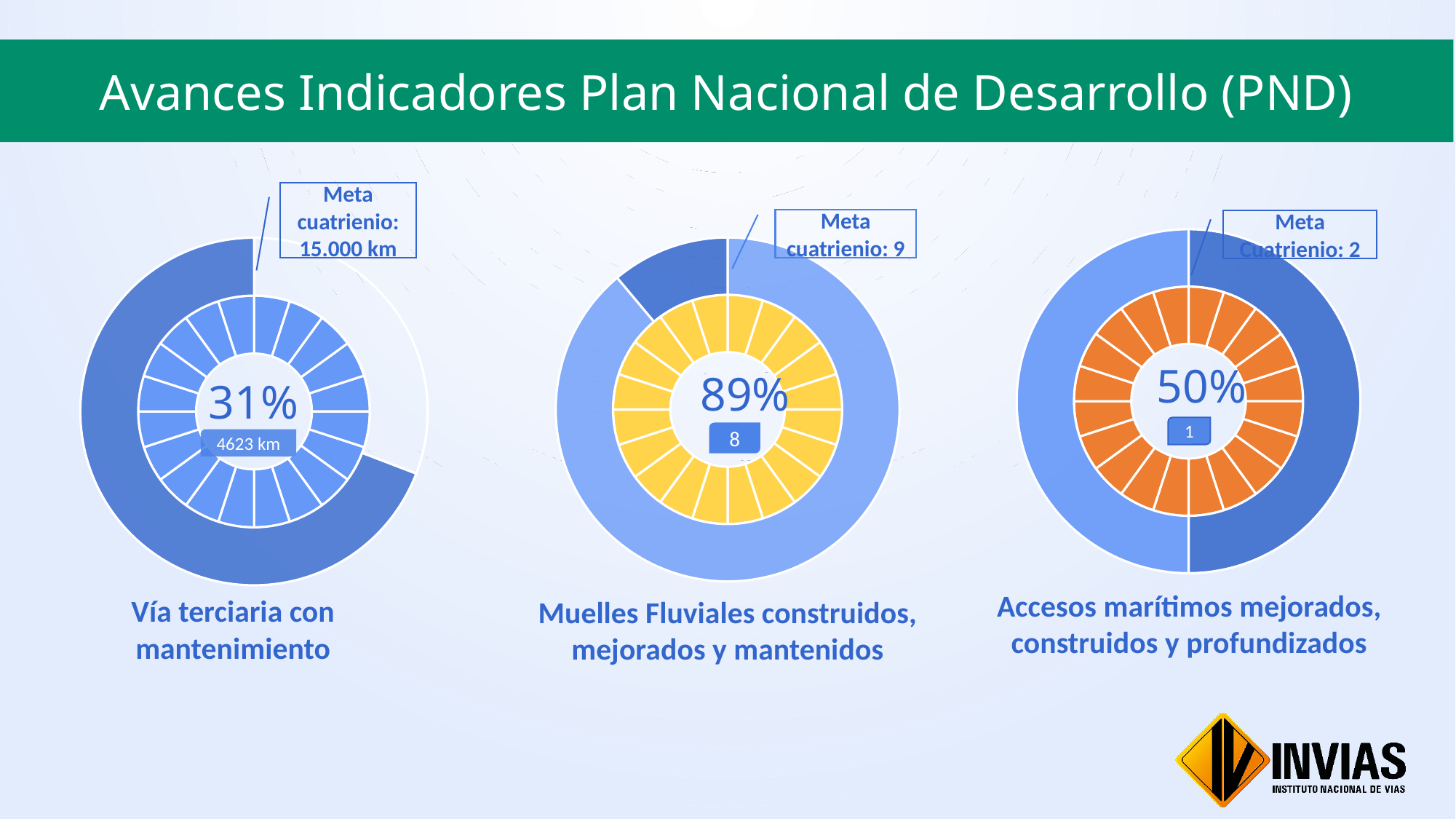
Which of the three indicators on the slide shows the lowest percentage of progress? Vía terciaria con mantenimiento On the 'Muelles Fluviales' chart, what is the 'Meta cuatrienio' target? 9 How many charts are shown on the slide? 3 What percentage of progress is shown on the 'Muelles Fluviales construidos, mejorados y mantenidos' chart? 89% On the 'Vía terciaria con mantenimiento' chart, how many kilometres have been achieved so far? 4623 km What percentage of progress is shown on the 'Accesos marítimos mejorados, construidos y profundizados' chart? 50% On the 'Accesos marítimos' chart, what is the 'Meta Cuatrienio' target? 2 On the 'Muelles Fluviales' chart, what is the difference between the 'Meta cuatrienio' target and the value achieved? 1 On the 'Vía terciaria con mantenimiento' chart, what is the 'Meta cuatrienio' target? 15.000 km What percentage of progress is shown on the 'Vía terciaria con mantenimiento' chart? 31% On the 'Muelles Fluviales' chart, what value has been achieved so far? 8 Which of the three indicators on the slide shows the highest percentage of progress? Muelles Fluviales construidos, mejorados y mantenidos